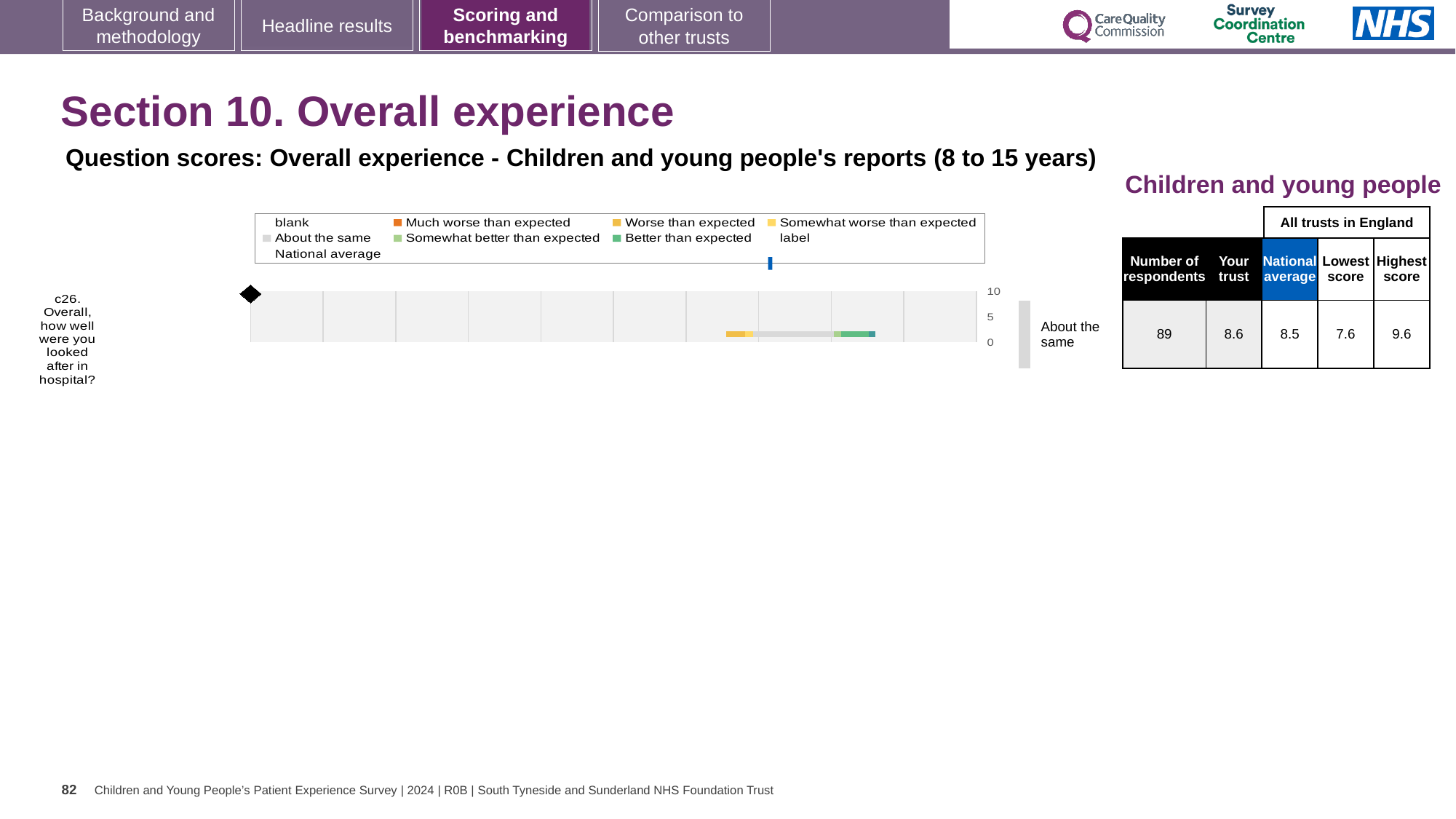
What kind of chart is shown for question c26 on the slide? bar chart For question c26, which is larger: the 'Your trust' score or the national average? Your trust What is the difference between the highest score and the lowest score for question c26 in the table beside the chart? 2.0 According to the table beside the chart, what is the lowest score among all trusts in England for question c26? 7.6 According to the table beside the chart, what is the 'Your trust' score for question c26? 8.6 What is the text of the question plotted in the chart? c26. Overall, how well were you looked after in hospital? According to the table beside the chart, what is the highest score among all trusts in England for question c26? 9.6 How many respondents answered question c26, according to the table beside the chart? 89 According to the table beside the chart, what is the national average score for question c26? 8.5 How many survey questions are plotted in the chart? 1 Is the 'Your trust' score for question c26 greater or less than 5 on the chart's axis? greater What benchmark category is shown next to the bar for question c26? About the same